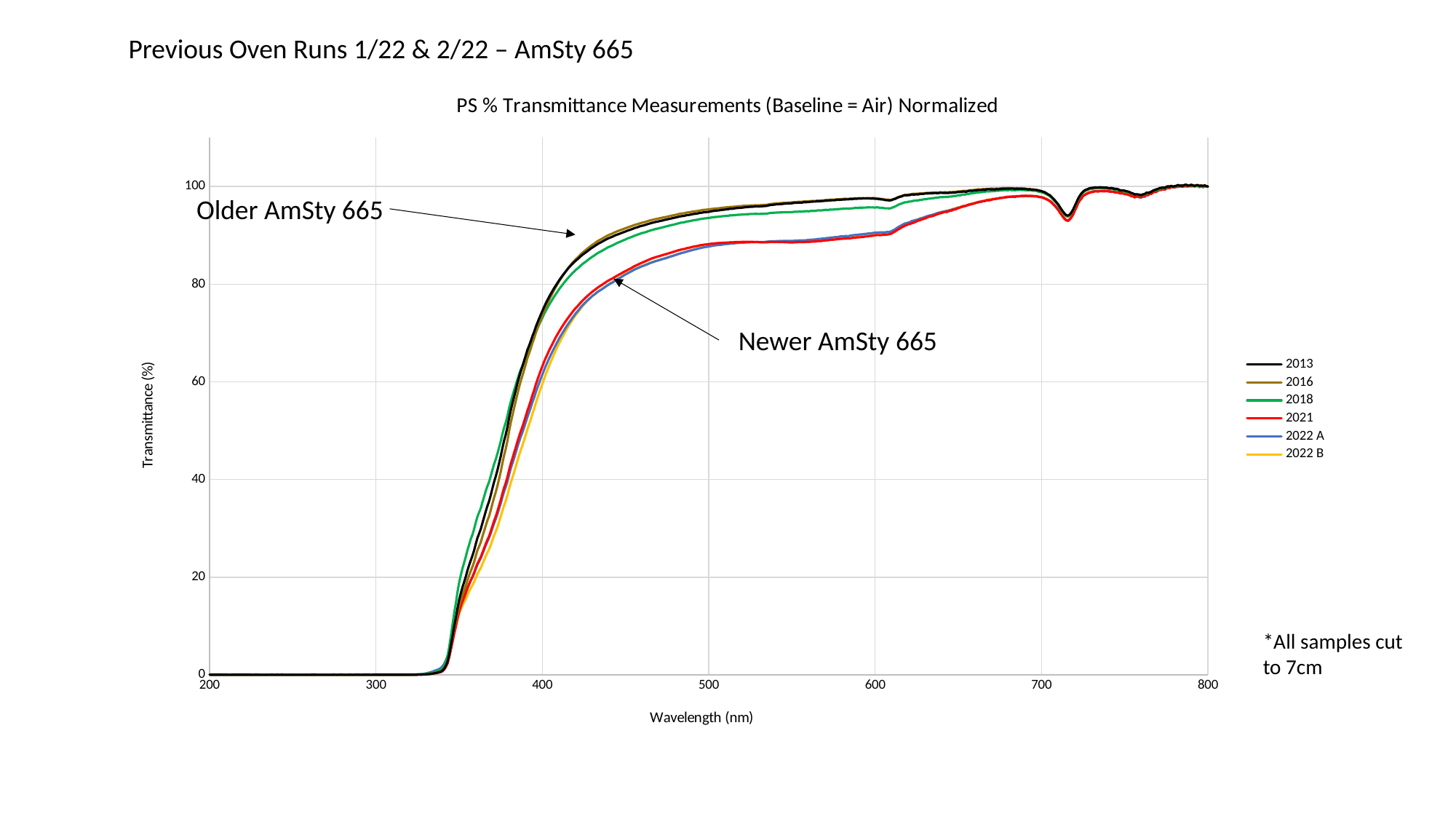
Is the value for 2021 at 600 nm greater or less than 80? greater Which series is plotted in red? 2021 How many series does the legend list? 6 What kind of chart is shown on the slide? Line chart At 600 nm, which series has the higher transmittance, 2018 or 2022 A? 2018 Is the value for 2022 B at 400 nm greater or less than 80? less What is the label of the x axis? Wavelength (nm) Do the transmittance values rise or fall as wavelength increases from 300 nm to 500 nm? rise Is the value for 2018 at 300 nm greater or less than 20? less At 500 nm, which series has the higher transmittance, 2013 or 2021? 2013 What is the title of the chart? PS % Transmittance Measurements (Baseline = Air) Normalized